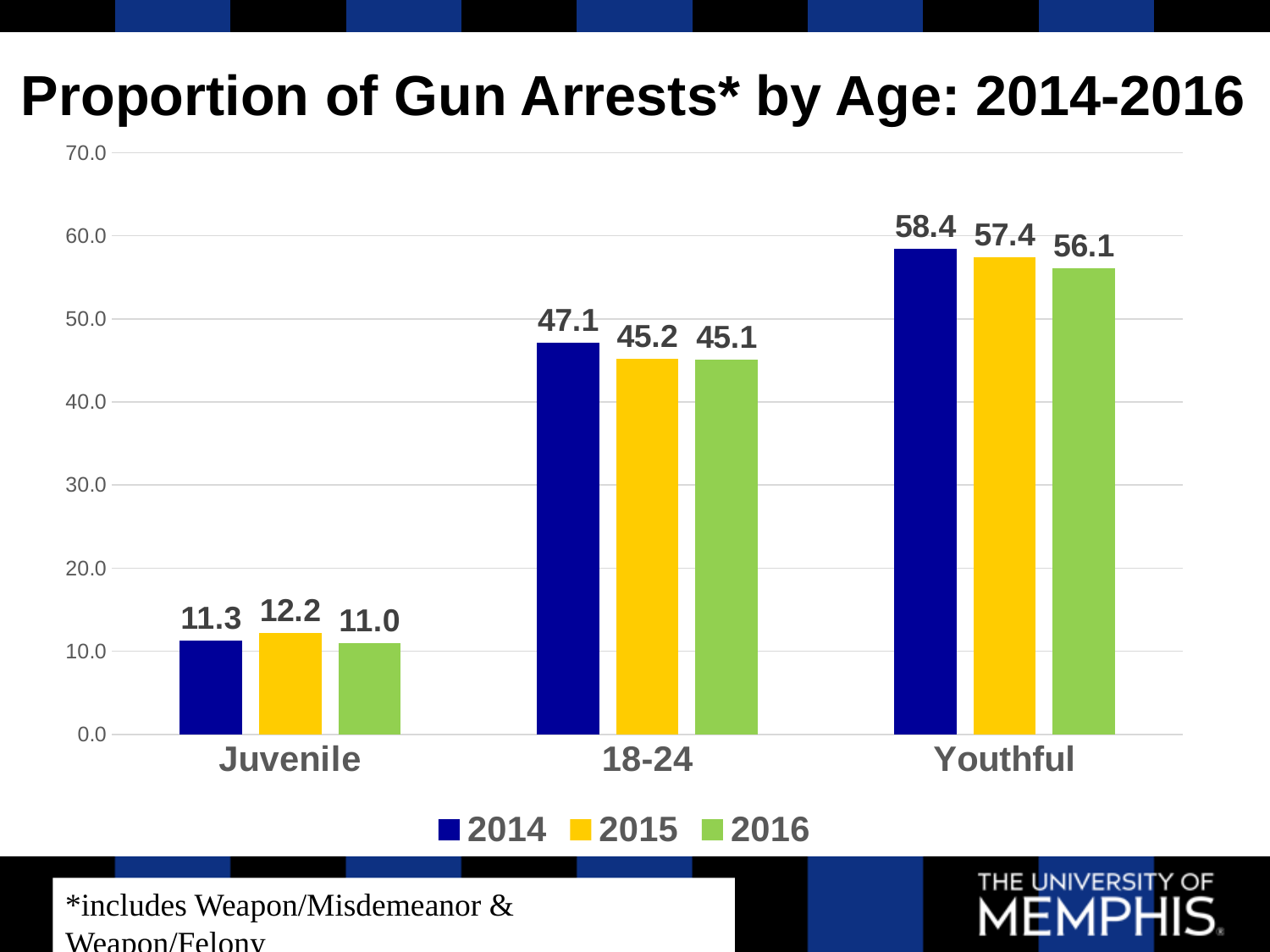
Which age category has the highest value in 2014? Youthful What is the value for 18-24 in 2015? 45.2 How many age categories are shown on the x axis? 3 Which is larger: the Juvenile value for 2015 or the Juvenile value for 2016? 2015 Is the value for 18-24 in 2014 greater or less than 40.0? greater What is the value for Juvenile in 2014? 11.3 Which age category has the lowest value in 2016? Juvenile What is the value for Youthful in 2016? 56.1 What kind of chart is shown on the slide? bar chart What is the difference between the Youthful values for 2014 and 2016? 2.3 How many series does the legend list? 3 What is the title of the chart? Proportion of Gun Arrests* by Age: 2014-2016